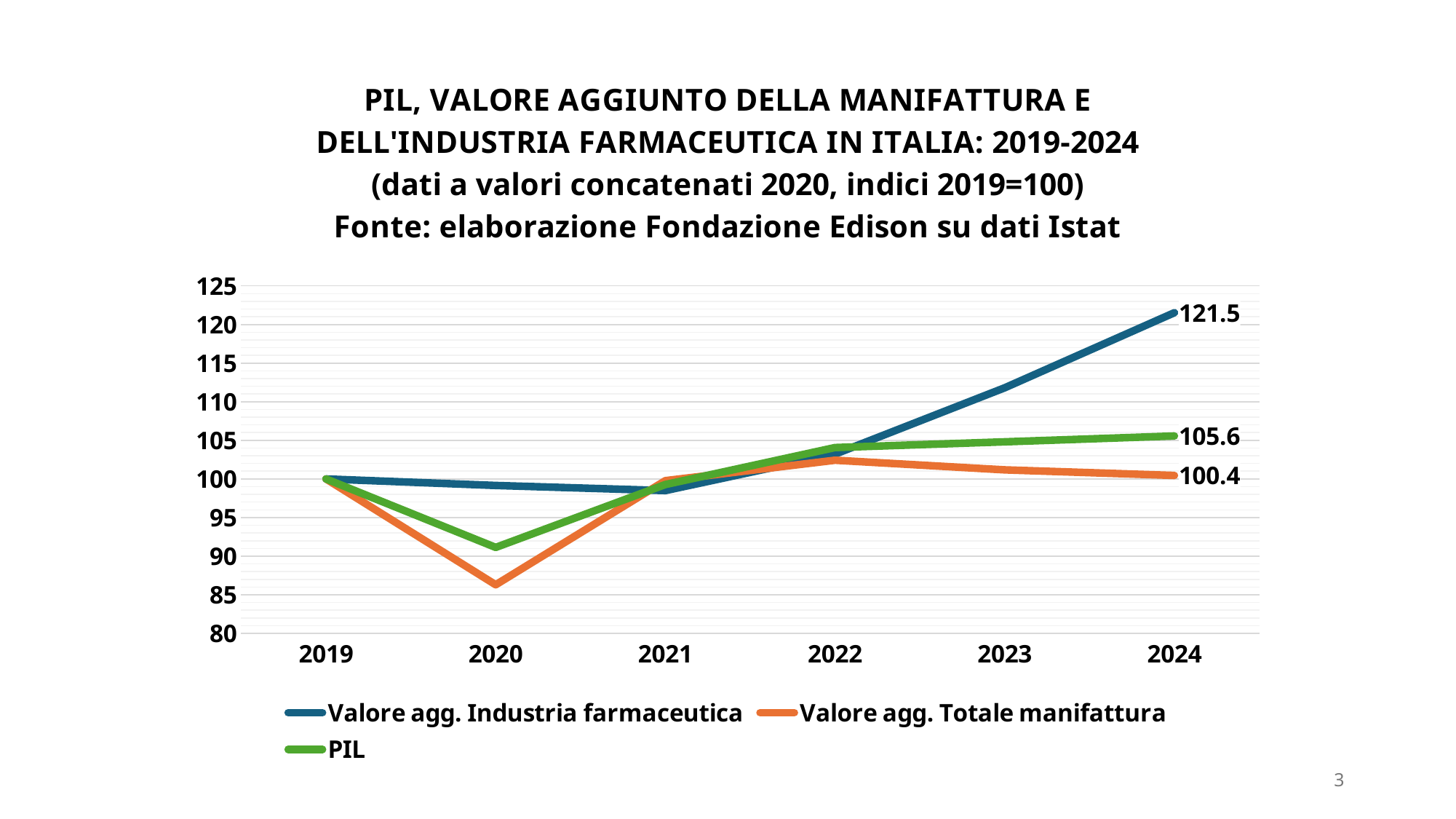
What is the 2024 value of the PIL series? 105.6 Is the 2020 value for PIL greater or less than 95? less Which series has the lowest value in 2024? Valore agg. Totale manifattura In 2024, which is larger: PIL or Valore agg. Totale manifattura? PIL How many years are shown on the x axis? 6 What is the difference between the 2024 values of Valore agg. Industria farmaceutica and Valore agg. Totale manifattura? 21.1 What is the 2024 value of the Valore agg. Totale manifattura series? 100.4 Is the 2020 value for Valore agg. Totale manifattura greater or less than 90? less Which series has the highest value in 2024? Valore agg. Industria farmaceutica What kind of chart is shown on the slide? line chart How many series does the legend list? 3 What is the 2024 value of the Valore agg. Industria farmaceutica series? 121.5